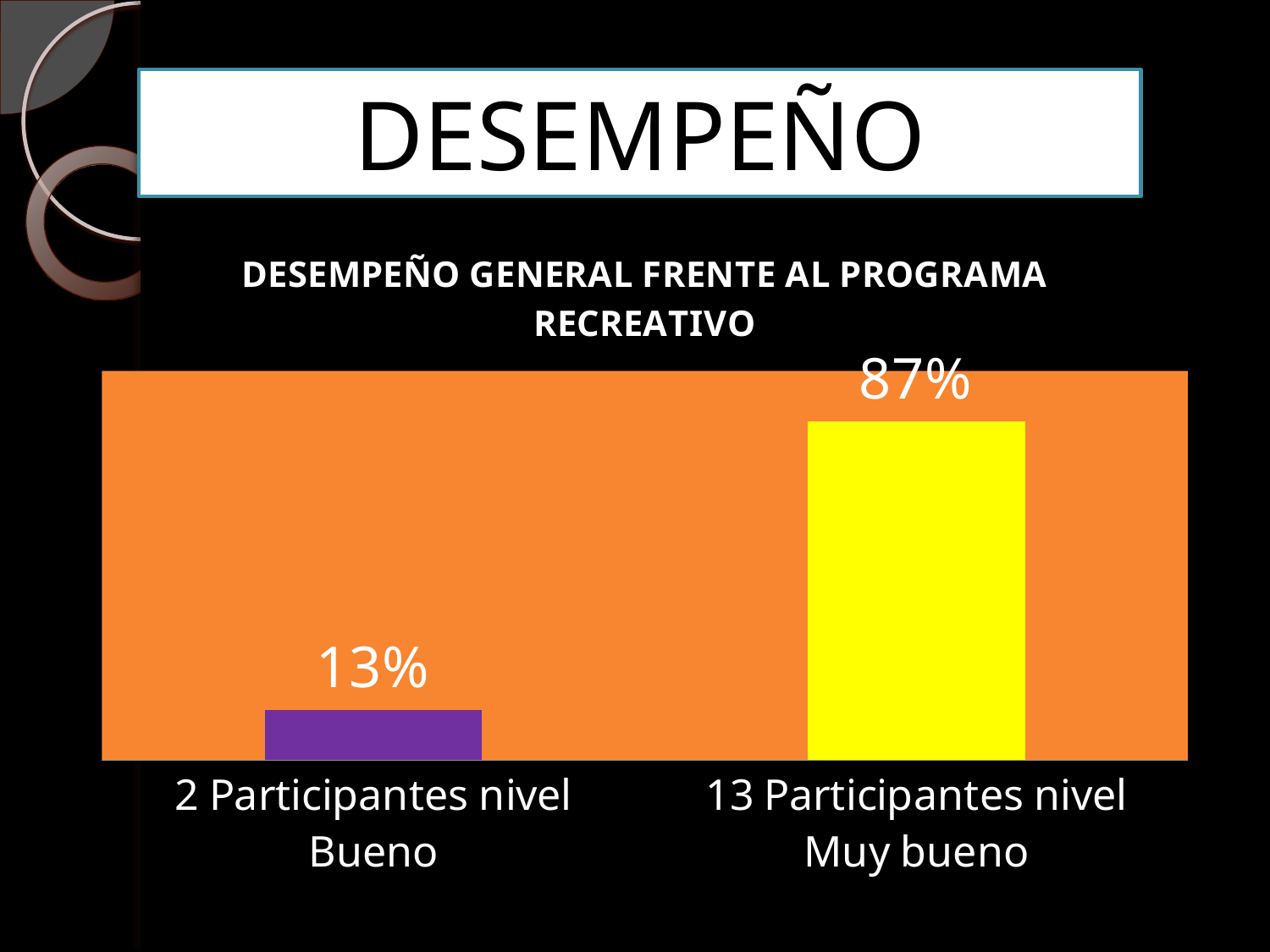
What is the title of the chart? DESEMPEÑO GENERAL FRENTE AL PROGRAMA RECREATIVO What kind of chart is shown on the slide? Bar chart Which is larger: the value for "2 Participantes nivel Bueno" or for "13 Participantes nivel Muy bueno"? 13 Participantes nivel Muy bueno What colour is the bar for "13 Participantes nivel Muy bueno"? Yellow Which category has the lowest value? 2 Participantes nivel Bueno Do the values rise or fall from left to right along the x axis? Rise What is the difference between the values for "13 Participantes nivel Muy bueno" and "2 Participantes nivel Bueno"? 74% How many categories are shown in the chart? 2 Which category has the highest value? 13 Participantes nivel Muy bueno What is the value for "13 Participantes nivel Muy bueno"? 87% What is the value for "2 Participantes nivel Bueno"? 13%